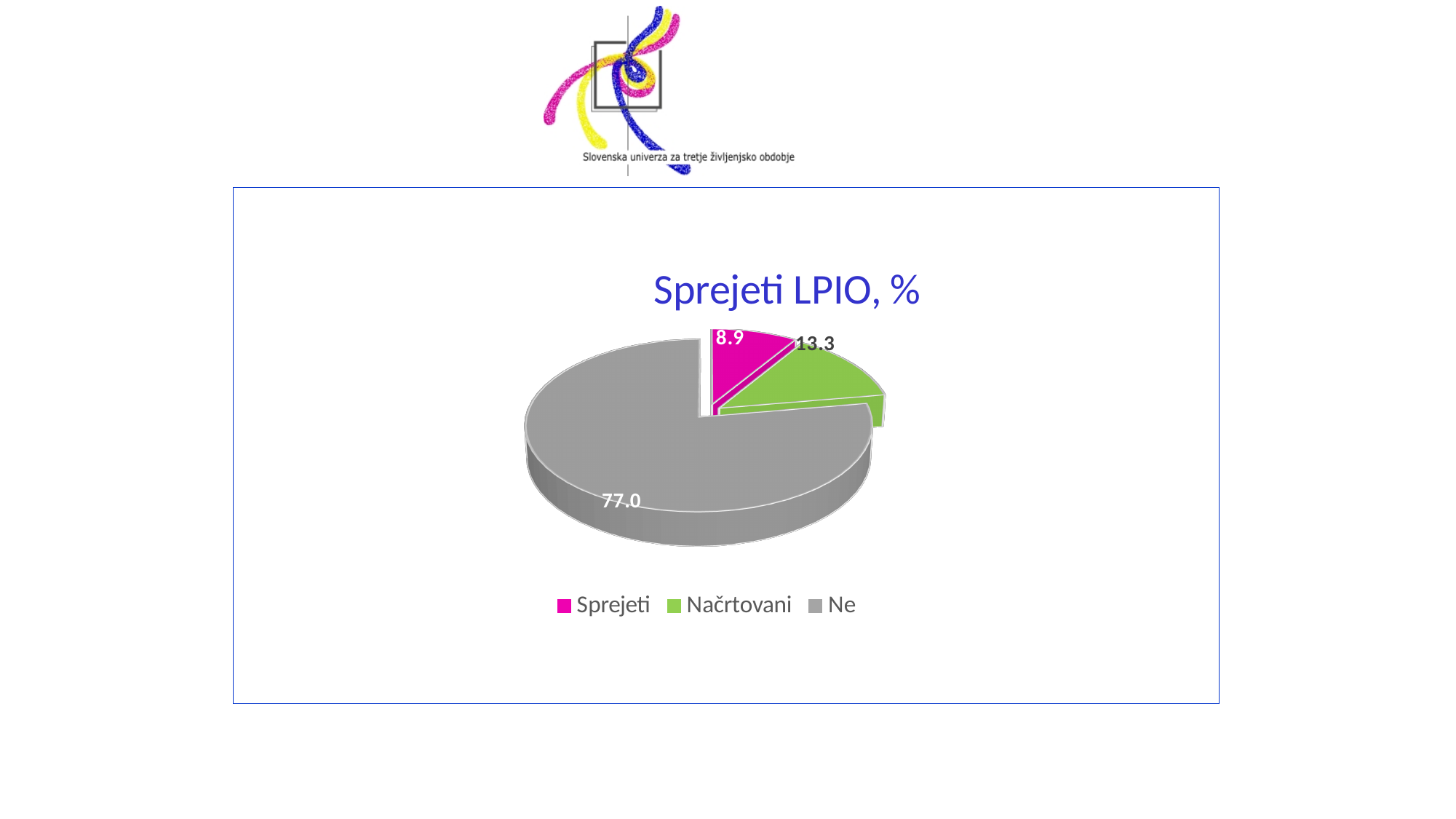
Which category has the largest slice? Ne What is the difference between the values for Načrtovani and Sprejeti? 4.4 What kind of chart is shown on the slide? Pie chart What is the value for Sprejeti? 8.9 What is the value for Načrtovani? 13.3 What is the difference between the values for Ne and Načrtovani? 63.7 Which category has the smallest slice? Sprejeti What colour is the Načrtovani slice? Green How many categories does the pie chart show? 3 What is the title of the chart? Sprejeti LPIO, % Which is larger, Sprejeti or Načrtovani? Načrtovani What is the value for Ne? 77.0